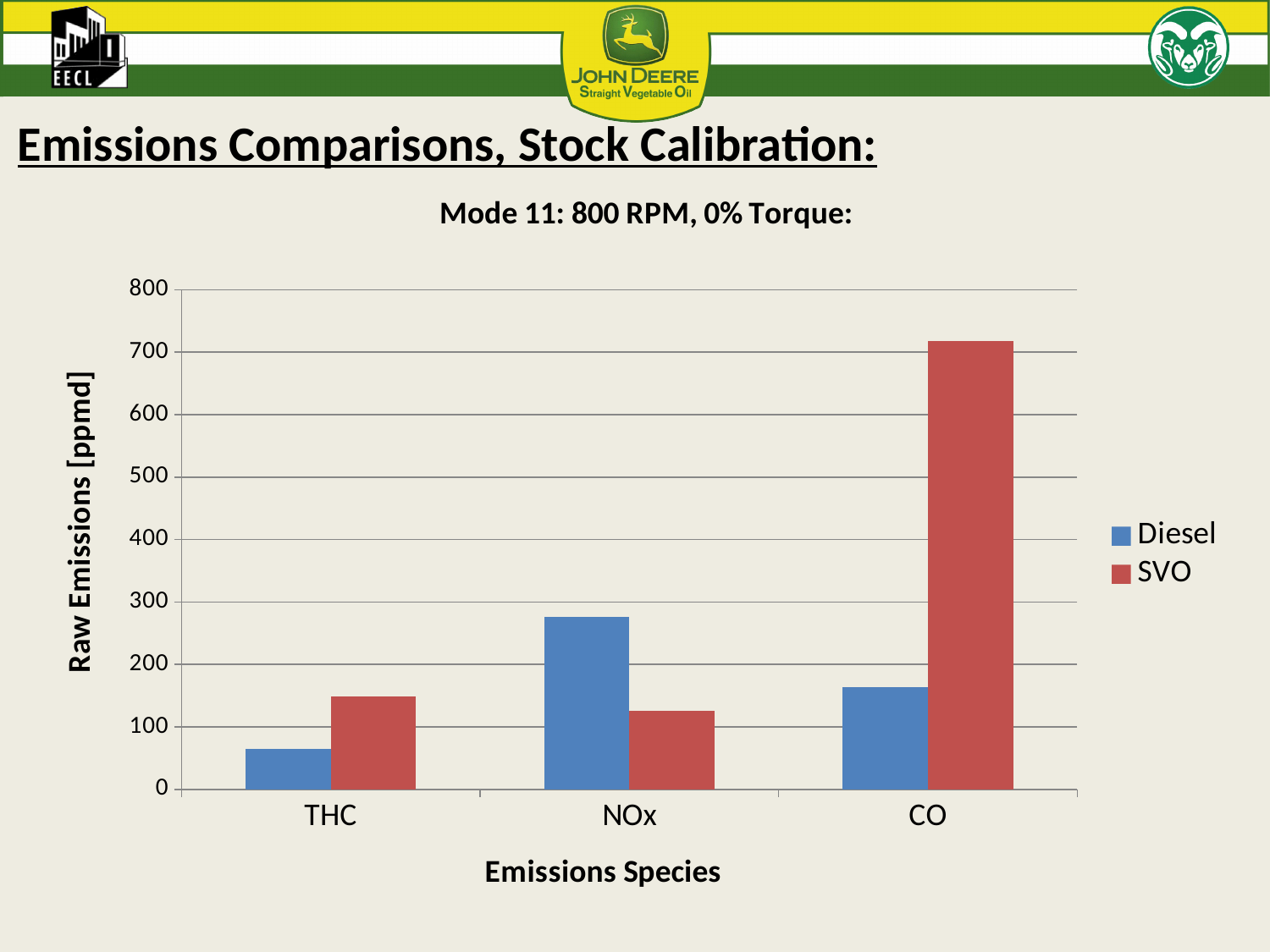
For which emissions species is the SVO value highest? CO Is the SVO value for CO greater or less than 700? greater Is the Diesel value for THC greater or less than 100? less For NOx, which is larger, the Diesel value or the SVO value? Diesel How many emissions species categories are shown on the x axis? 3 What is the label of the y axis? Raw Emissions [ppmd] For CO, which is larger, the Diesel value or the SVO value? SVO What kind of chart is shown on the slide? bar chart For which emissions species is the Diesel value lowest? THC Is the Diesel value for NOx greater or less than 200? greater How many series does the legend list? 2 For which emissions species is the Diesel value highest? NOx